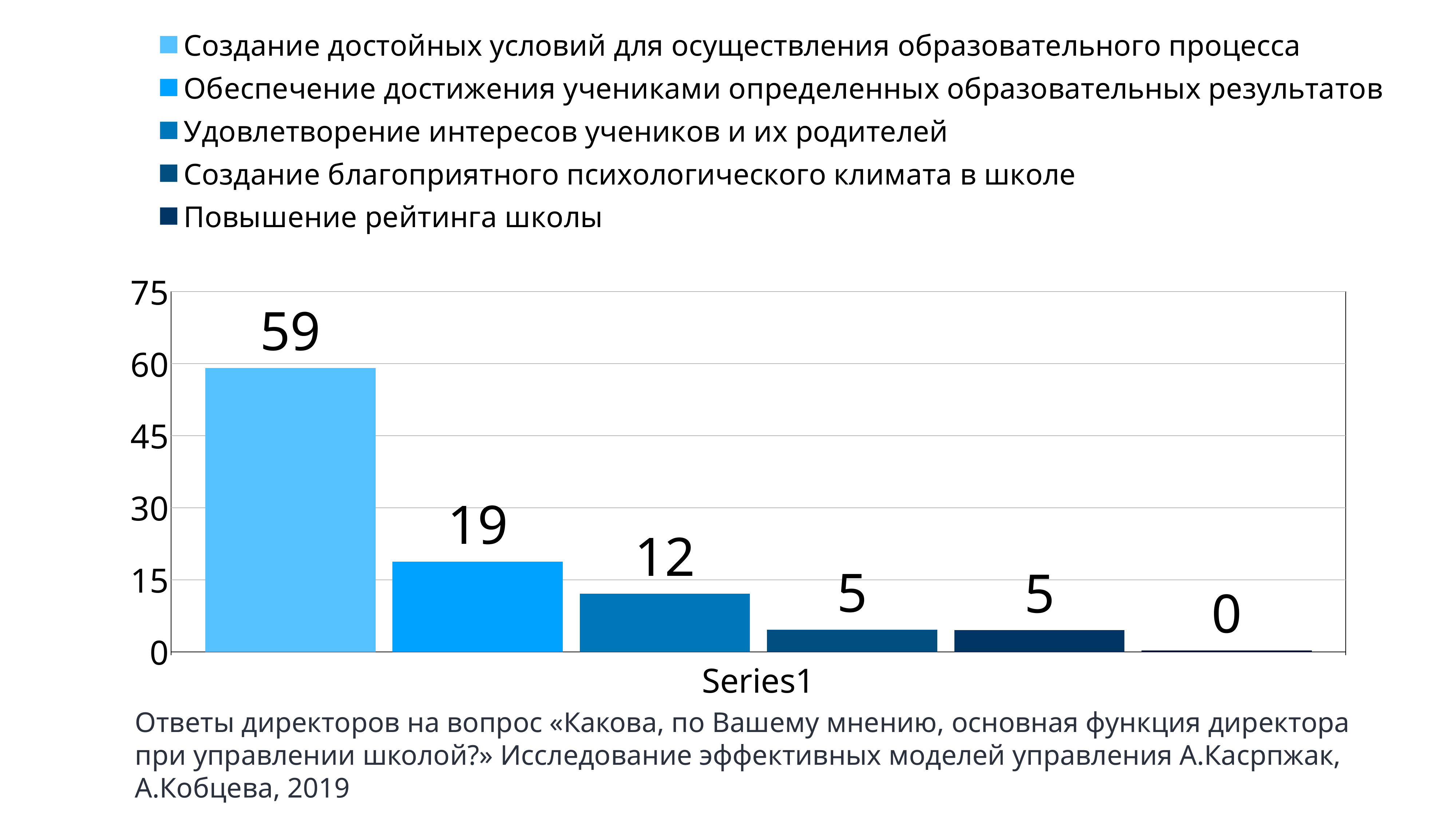
Which is larger: the value for «Обеспечение достижения учениками определенных образовательных результатов» or for «Удовлетворение интересов учеников и их родителей»? Обеспечение достижения учениками определенных образовательных результатов How many entries does the legend list? 5 What value is shown for «Создание достойных условий для осуществления образовательного процесса»? 59 Which legend category has the highest value? Создание достойных условий для осуществления образовательного процесса What value is shown for «Обеспечение достижения учениками определенных образовательных результатов»? 19 Do the bar values rise or fall from left to right? fall What value is shown for «Удовлетворение интересов учеников и их родителей»? 12 Is the value for «Создание достойных условий для осуществления образовательного процесса» greater or less than 45? greater What is the difference between the values for «Создание достойных условий для осуществления образовательного процесса» and «Обеспечение достижения учениками определенных образовательных результатов»? 40 What kind of chart is shown on the slide? bar chart What value is shown for «Повышение рейтинга школы»? 5 What value is shown for «Создание благоприятного психологического климата в школе»? 5